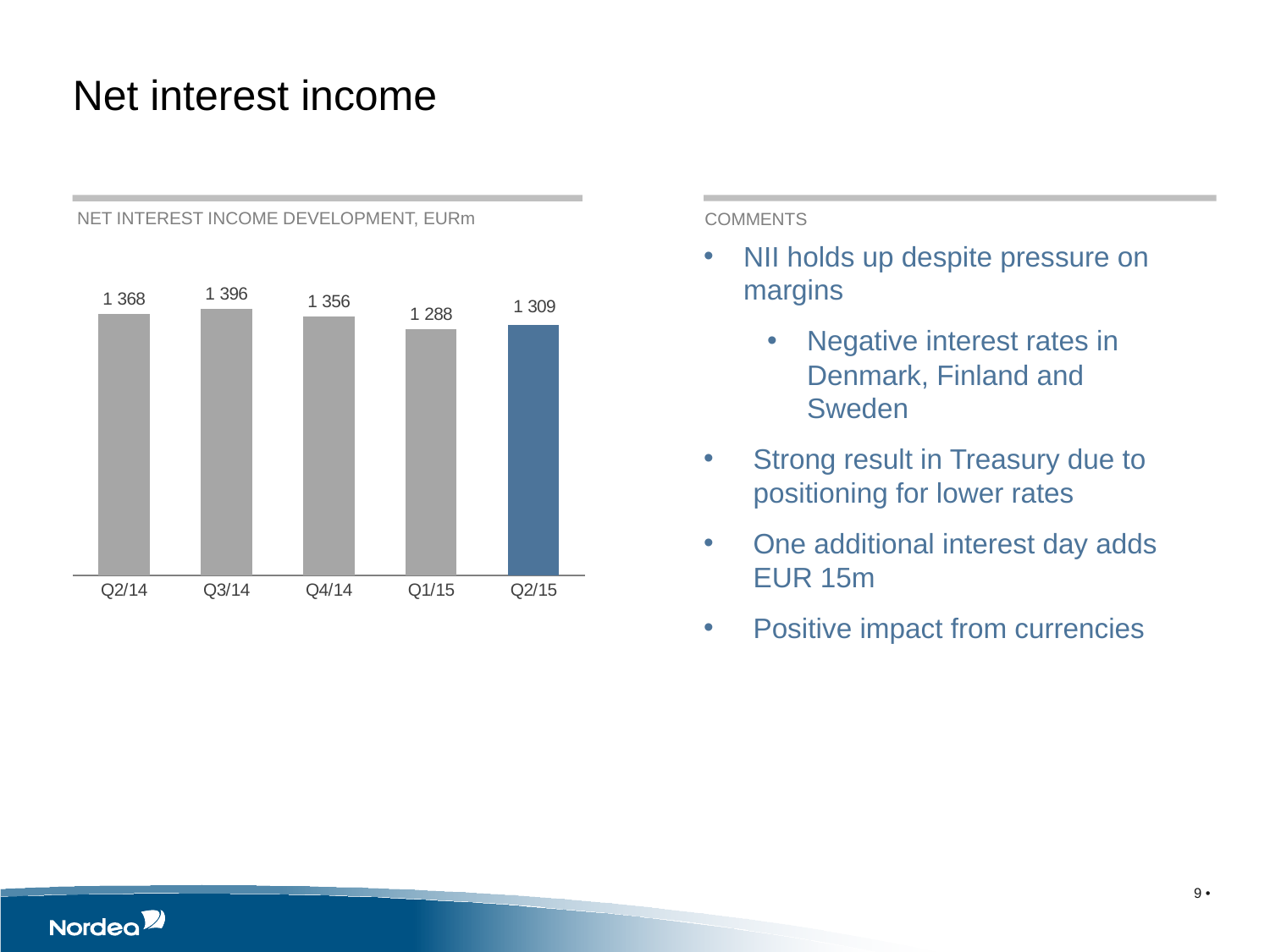
What is the net interest income for Q2/14? 1 368 What is the difference in net interest income between Q2/15 and Q1/15? 21 Which quarter has the highest net interest income? Q3/14 What is the net interest income for Q2/15? 1 309 What is the difference in net interest income between Q3/14 and Q1/15? 108 What is the net interest income for Q1/15? 1 288 How many quarters are shown in the chart? 5 Which is larger, the net interest income for Q4/14 or for Q2/15? Q4/14 Does net interest income rise or fall from Q3/14 to Q1/15? Fall What kind of chart is shown on the slide? Bar chart What is the title of the chart? NET INTEREST INCOME DEVELOPMENT, EURm Which quarter has the lowest net interest income? Q1/15